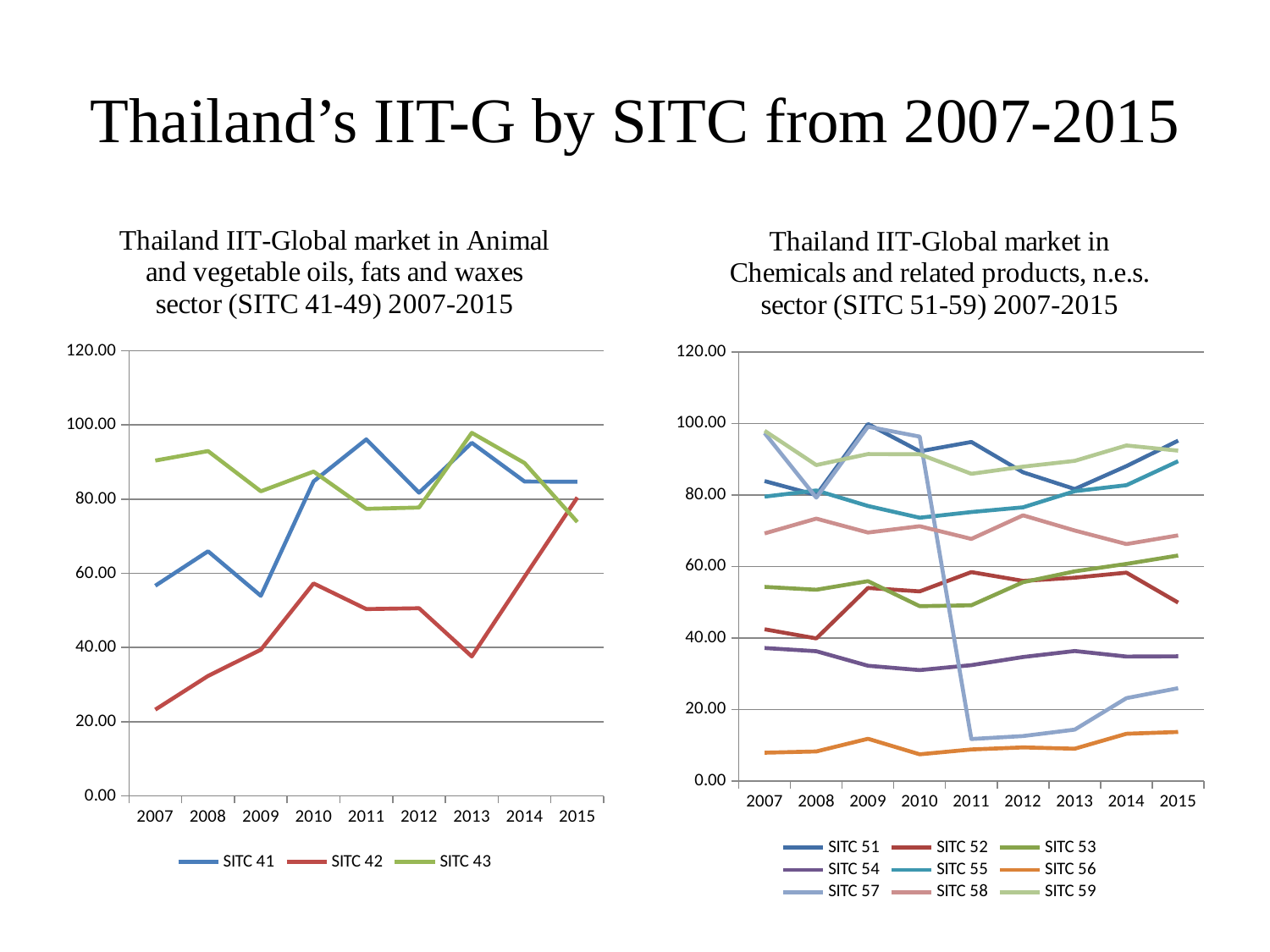
How many years are plotted along the x axis of the right chart (SITC 51-59)? 9 In the right chart (SITC 51-59), which series has the lowest value in 2007? SITC 56 In the left chart (SITC 41-49), which series has the lowest value in 2009? SITC 42 How many series does the legend of the right chart (SITC 51-59) list? 9 In the left chart (SITC 41-49), is the value for SITC 41 in 2011 greater or less than 80? greater In the left chart (SITC 41-49), does the value for SITC 42 rise or fall from 2007 to 2015? rise In the left chart (SITC 41-49), which series has the higher value in 2007, SITC 42 or SITC 43? SITC 43 In the right chart (SITC 51-59), is the value for SITC 51 in 2009 greater or less than 80? greater In the right chart (SITC 51-59), is the value for SITC 57 in 2011 greater or less than 20? less What kind of chart is the left chart (SITC 41-49)? Line chart How many series does the legend of the left chart (SITC 41-49) list? 3